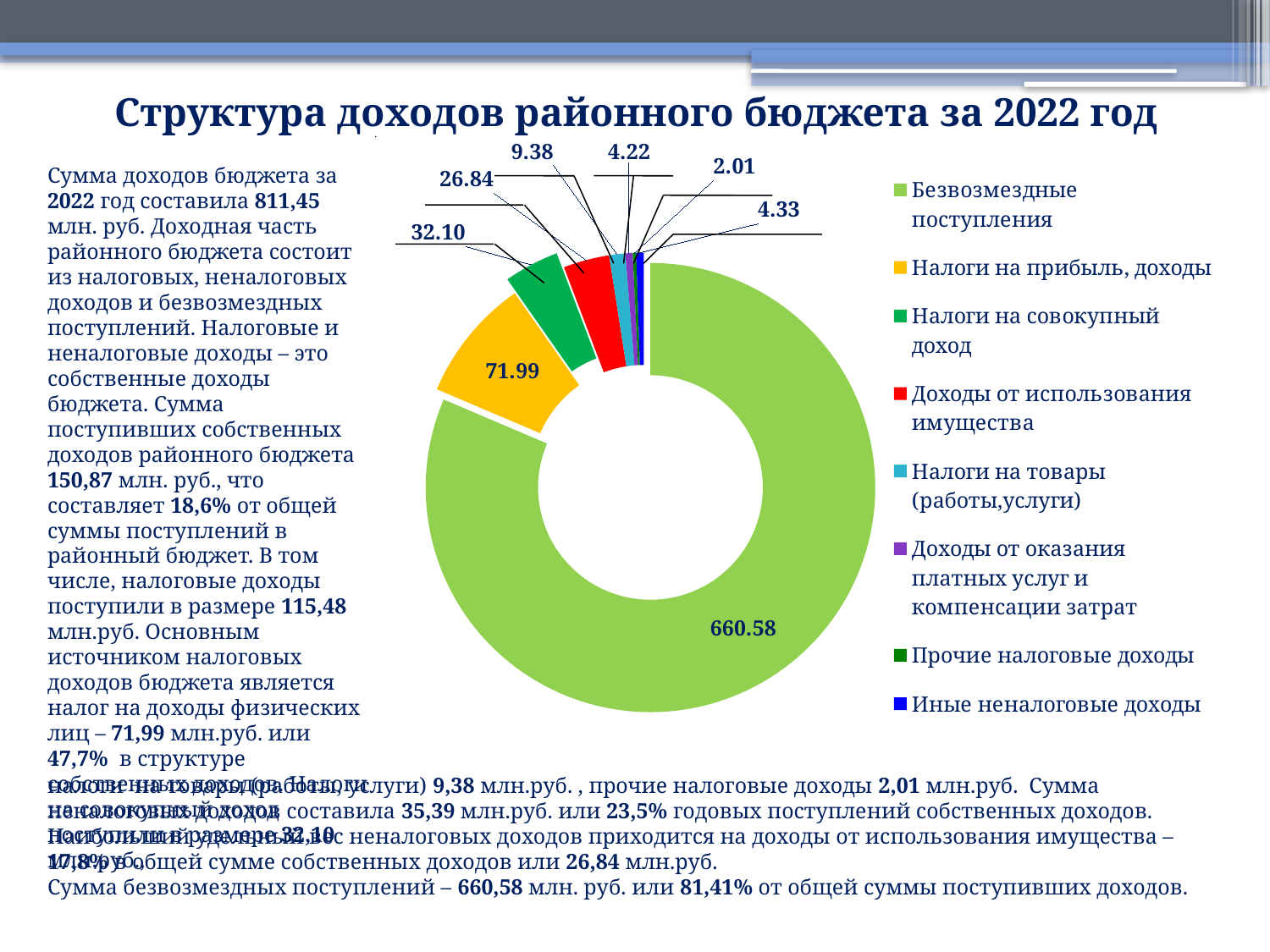
What is the value for Налоги на товары (работы,услуги)? 9.38 Which is larger: Налоги на совокупный доход or Доходы от использования имущества? Налоги на совокупный доход What is the difference between Налоги на прибыль, доходы and Налоги на совокупный доход? 39.89 Which category has the smallest slice? Прочие налоговые доходы What is the value for Налоги на прибыль, доходы? 71.99 What is the value for Доходы от использования имущества? 26.84 How many categories does the legend list? 8 What is the value for Налоги на совокупный доход? 32.10 Which category has the largest slice? Безвозмездные поступления What is the value for Безвозмездные поступления? 660.58 What kind of chart is shown on the slide? doughnut chart What is the title of the slide's chart section? Структура доходов районного бюджета за 2022 год